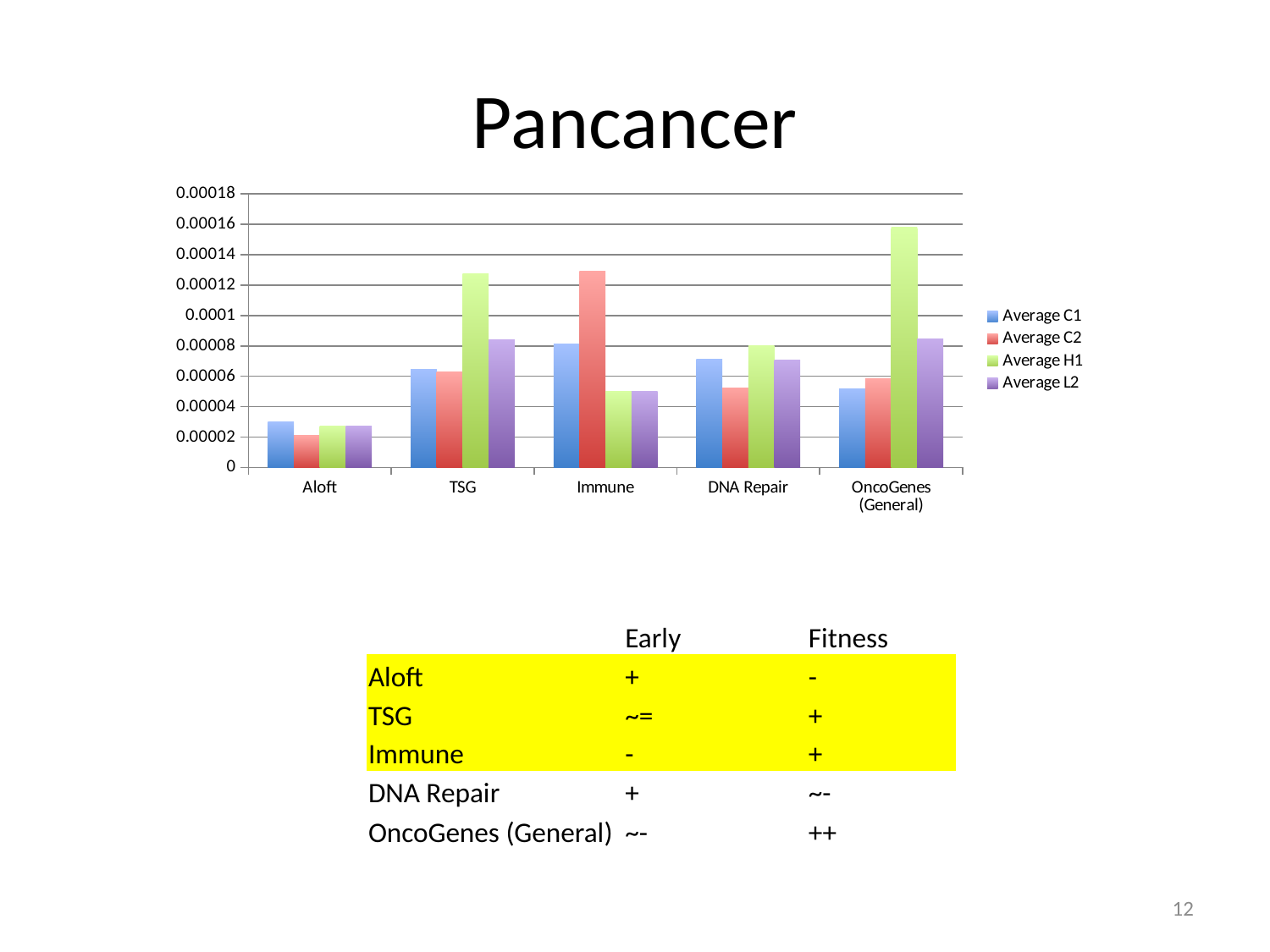
Which is larger: the Average H1 value for TSG or the Average H1 value for DNA Repair? TSG How many categories are shown on the x axis of the chart? 5 What colour represents the Average H1 series in the chart? green For the DNA Repair category, which series has the lowest value? Average C2 How many series does the chart legend list? 4 Which category has the lowest Average C1 value? Aloft Which category has the highest Average H1 value? OncoGenes (General) Is the Average C1 value for Aloft greater or less than 0.00004? less For the Immune category, which series has the highest value? Average C2 Is the Average C2 value for Immune greater or less than 0.00012? greater What type of chart is shown on the slide? bar chart Is the Average H1 value for OncoGenes (General) greater or less than 0.00014? greater